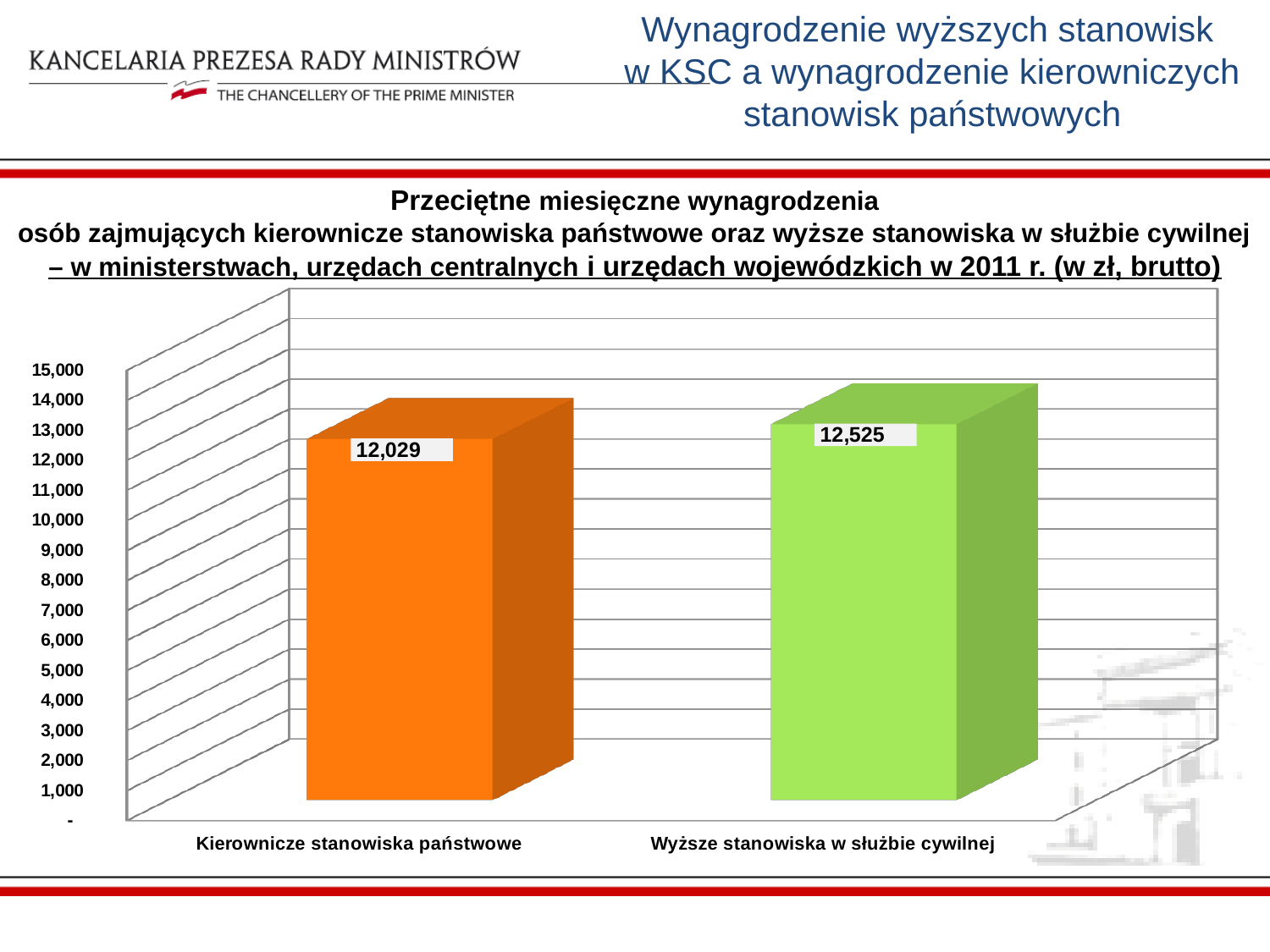
Which category has the highest value? Wyższe stanowiska w służbie cywilnej What is the value for Wyższe stanowiska w służbie cywilnej? 12,525 What is the value for Kierownicze stanowiska państwowe? 12,029 What kind of chart is shown on the slide? bar chart What is the highest value labelled on the vertical axis? 15,000 Is the value for Wyższe stanowiska w służbie cywilnej greater or less than 12,000? greater What is the difference between the values for Wyższe stanowiska w służbie cywilnej and Kierownicze stanowiska państwowe? 496 Which category has the lowest value? Kierownicze stanowiska państwowe Is the value for Kierownicze stanowiska państwowe greater or less than 13,000? less What colour is the bar for Wyższe stanowiska w służbie cywilnej? green Which is larger: the value for Kierownicze stanowiska państwowe or the value for Wyższe stanowiska w służbie cywilnej? Wyższe stanowiska w służbie cywilnej How many categories are shown in the chart? 2